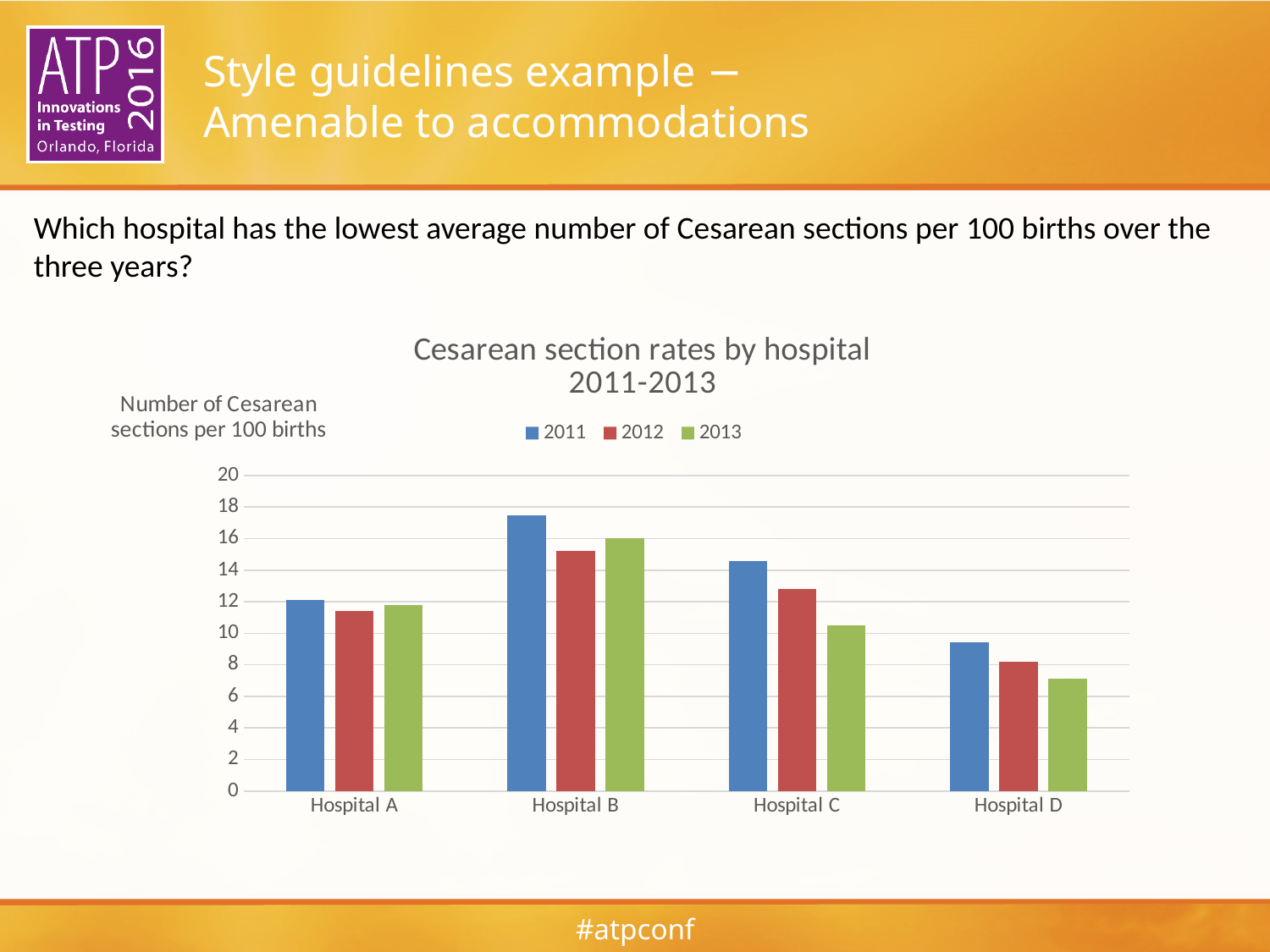
Which hospital has the lowest value for 2013? Hospital D Which is larger for Hospital C: the 2011 value or the 2013 value? 2011 How many hospitals are shown on the x axis? 4 What kind of chart is shown on the slide? bar chart Which hospital has the highest value for 2011? Hospital B Is the value for Hospital C in 2013 greater or less than 12? less Is the value for Hospital B in 2011 greater or less than 16? greater What is the label on the vertical axis? Number of Cesarean sections per 100 births Do the values for Hospital D rise or fall from 2011 to 2013? fall What is the title of the chart? Cesarean section rates by hospital 2011-2013 How many series does the legend list? 3 Is the value for Hospital D in 2013 greater or less than 8? less